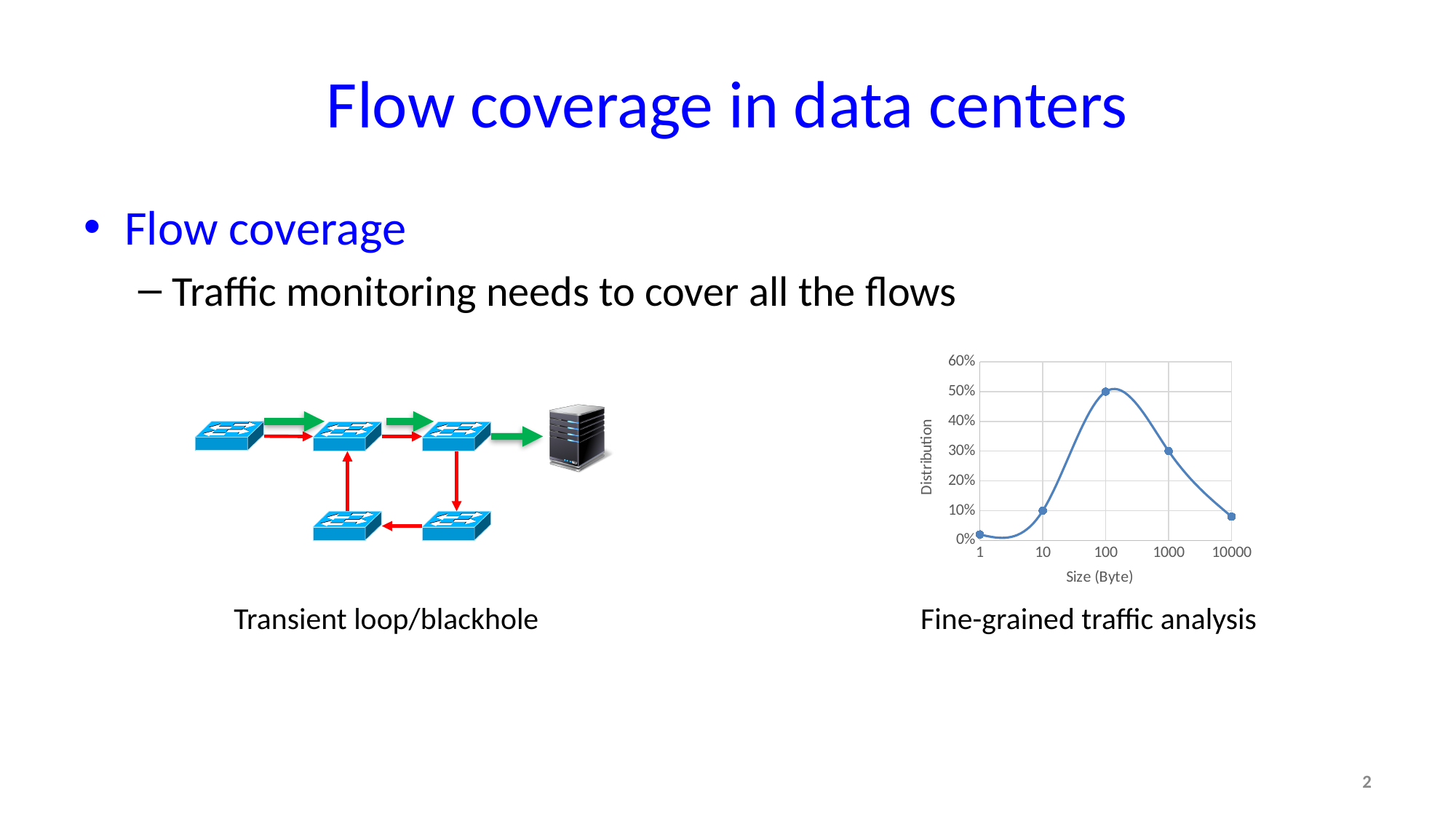
What is the Distribution value at Size 10 Bytes? 10% What is the label of the x axis of the chart? Size (Byte) What kind of chart is shown on the slide? line chart At which Size (Byte) is the Distribution lowest? 1 What is the difference between the Distribution at Size 100 and at Size 1000? 20% What is the Distribution value at Size 100 Bytes? 50% How does the Distribution change as Size increases from 100 to 10000 Bytes? It falls Is the Distribution value at Size 10000 greater or less than 10%? less Which has a larger Distribution, Size 100 or Size 1000? 100 What is the Distribution value at Size 1000 Bytes? 30% At which Size (Byte) is the Distribution highest? 100 How many data points are plotted on the chart? 5